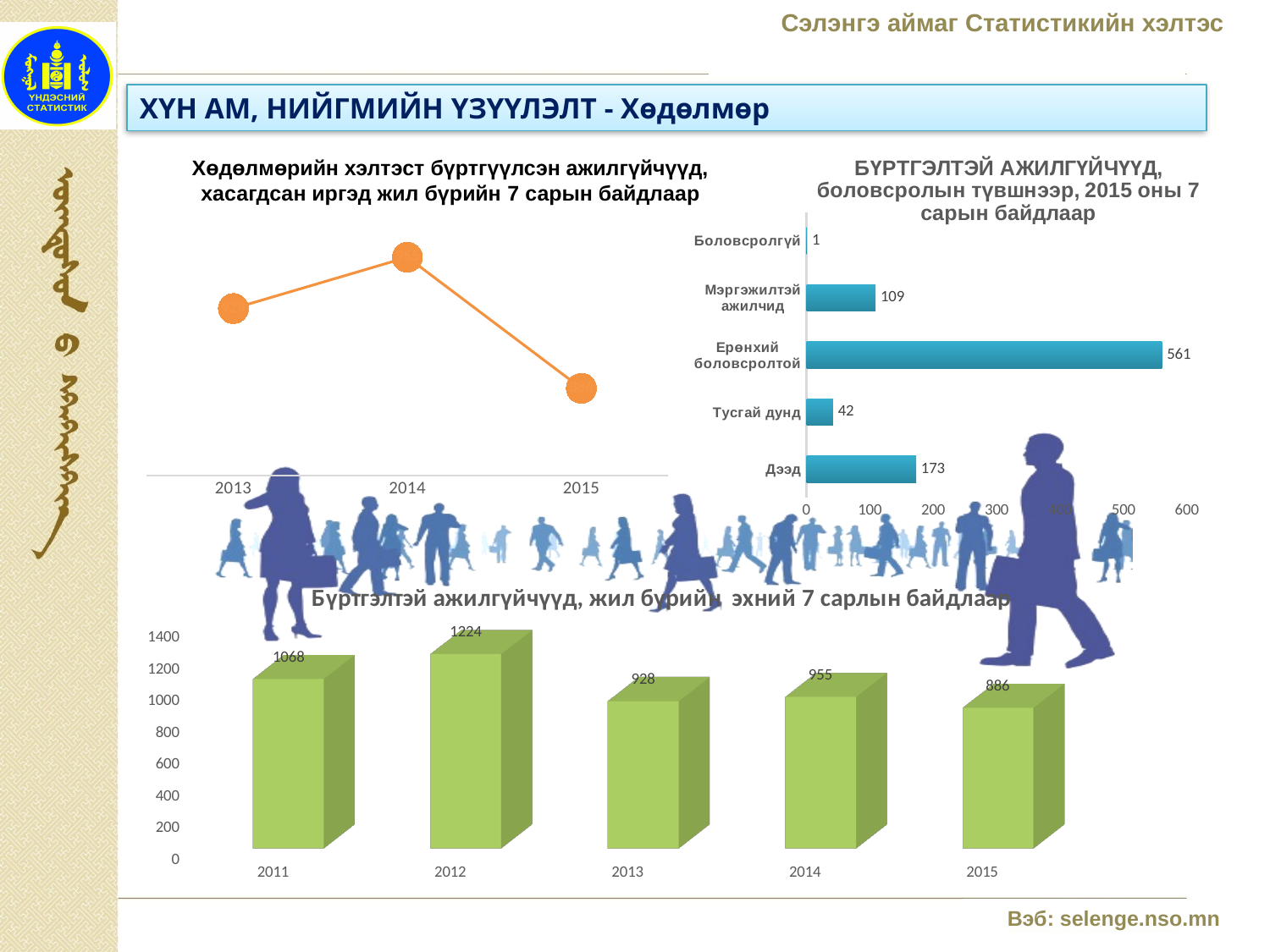
In the chart titled 'БҮРТГЭЛТЭЙ АЖИЛГҮЙЧҮҮД, боловсролын түвшнээр, 2015 оны 7 сарын байдлаар', what is the value for 'Ерөнхий боловсролтой'? 561 In the chart titled 'Бүртгэлтэй ажилгүйчүүд, жил бүрийн эхний 7 сарлын байдлаар', what is the value for 2012? 1224 In the chart titled 'БҮРТГЭЛТЭЙ АЖИЛГҮЙЧҮҮД, боловсролын түвшнээр, 2015 оны 7 сарын байдлаар', how many categories are shown? 5 In the chart titled 'Бүртгэлтэй ажилгүйчүүд, жил бүрийн эхний 7 сарлын байдлаар', what is the difference between 2011 and 2015? 182 In the chart titled 'БҮРТГЭЛТЭЙ АЖИЛГҮЙЧҮҮД, боловсролын түвшнээр, 2015 оны 7 сарын байдлаар', what is the difference between 'Дээд' and 'Мэргэжилтэй ажилчид'? 64 What kind of chart is 'Бүртгэлтэй ажилгүйчүүд, жил бүрийн эхний 7 сарлын байдлаар'? bar chart What kind of chart is 'Хөдөлмөрийн хэлтэст бүртгүүлсэн ажилгүйчүүд, хасагдсан иргэд жил бүрийн 7 сарын байдлаар'? line chart In the chart titled 'Хөдөлмөрийн хэлтэст бүртгүүлсэн ажилгүйчүүд, хасагдсан иргэд жил бүрийн 7 сарын байдлаар', which year has the highest point? 2014 In the chart titled 'Бүртгэлтэй ажилгүйчүүд, жил бүрийн эхний 7 сарлын байдлаар', which year has the lowest value? 2015 In the chart titled 'БҮРТГЭЛТЭЙ АЖИЛГҮЙЧҮҮД, боловсролын түвшнээр, 2015 оны 7 сарын байдлаар', which category has the lowest value? Боловсролгүй In the chart titled 'БҮРТГЭЛТЭЙ АЖИЛГҮЙЧҮҮД, боловсролын түвшнээр, 2015 оны 7 сарын байдлаар', what is the value for 'Дээд'? 173 In the chart titled 'Бүртгэлтэй ажилгүйчүүд, жил бүрийн эхний 7 сарлын байдлаар', which is larger, the value for 2013 or 2014? 2014